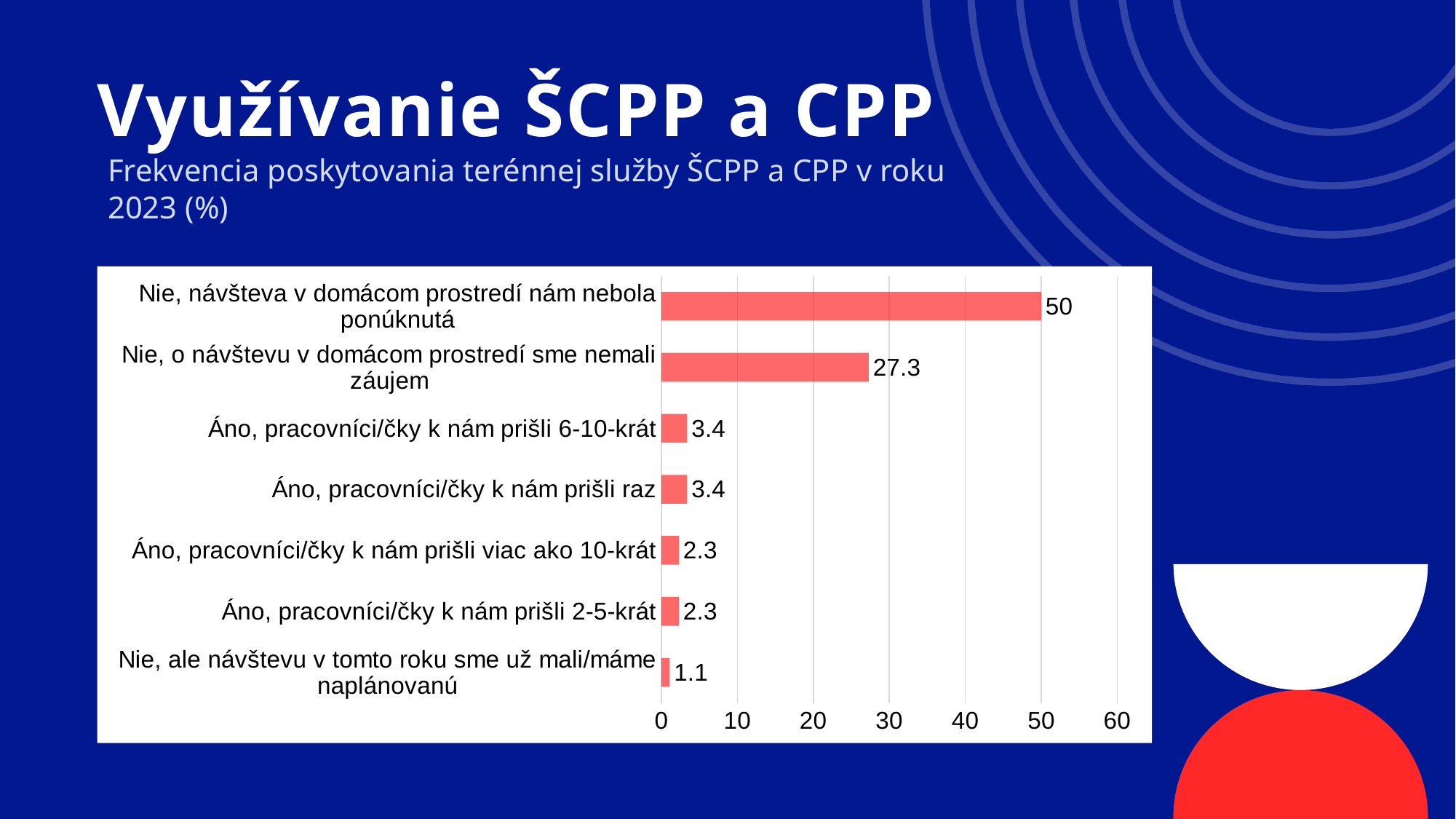
What is the difference between the values for "Nie, návšteva v domácom prostredí nám nebola ponúknutá" and "Nie, o návštevu v domácom prostredí sme nemali záujem"? 22.7 How many categories are shown in the chart? 7 What is the value for "Nie, ale návštevu v tomto roku sme už mali/máme naplánovanú"? 1.1 Which category has the highest value? Nie, návšteva v domácom prostredí nám nebola ponúknutá What is the value for "Áno, pracovníci/čky k nám prišli raz"? 3.4 What is the value for "Nie, o návštevu v domácom prostredí sme nemali záujem"? 27.3 What is the value for "Nie, návšteva v domácom prostredí nám nebola ponúknutá"? 50 Is the value for "Nie, o návštevu v domácom prostredí sme nemali záujem" greater or less than 30? less What is the maximum value shown on the horizontal axis? 60 Which category has the lowest value? Nie, ale návštevu v tomto roku sme už mali/máme naplánovanú What kind of chart is shown on the slide? bar chart Which is larger: the value for "Áno, pracovníci/čky k nám prišli 6-10-krát" or the value for "Áno, pracovníci/čky k nám prišli 2-5-krát"? Áno, pracovníci/čky k nám prišli 6-10-krát